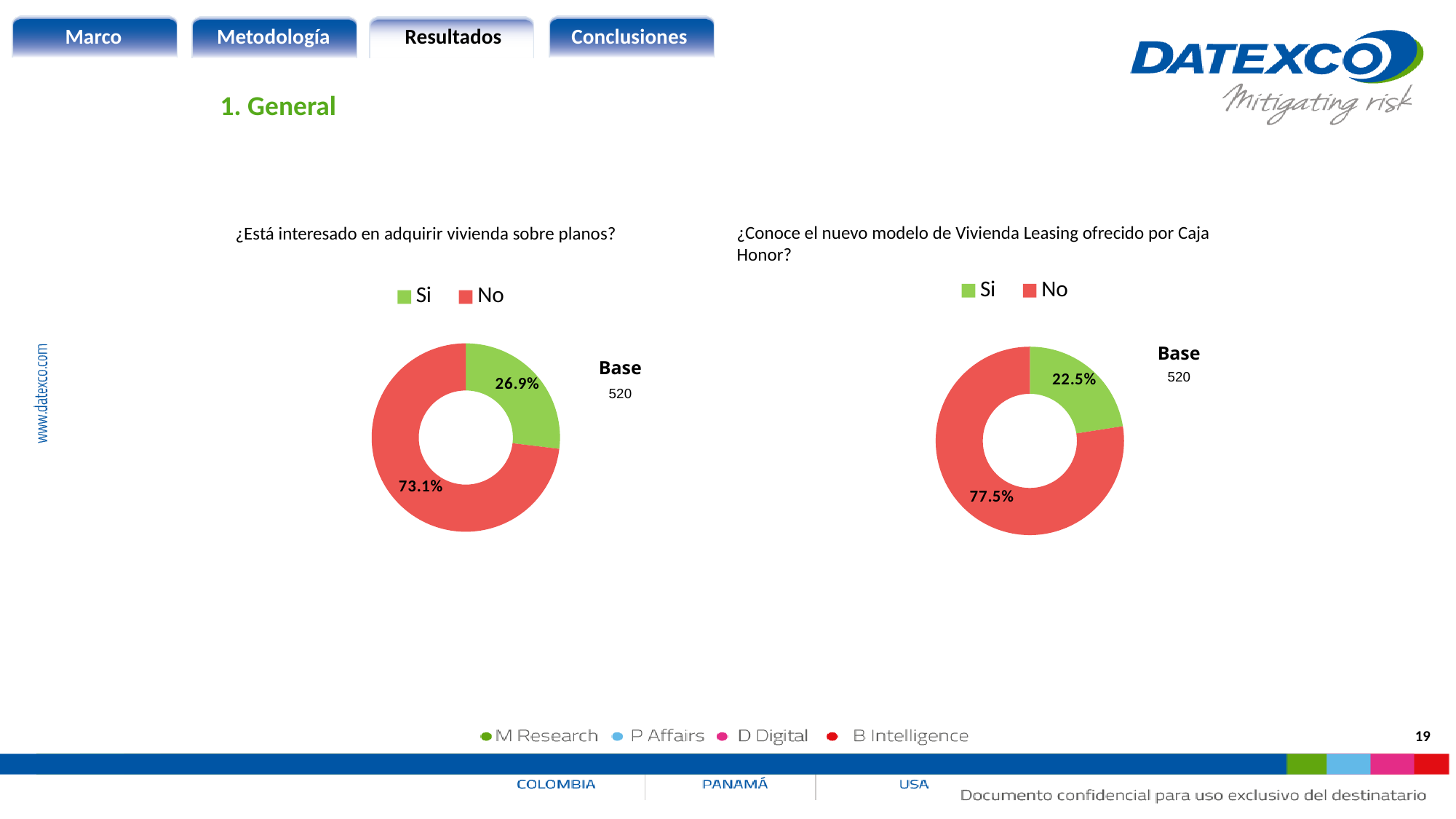
In the right chart, what is the difference between the No and Si percentages? 55.0% In the right chart (¿Conoce el nuevo modelo de Vivienda Leasing ofrecido por Caja Honor?), what percentage answered No? 77.5% What type of chart is used on the left of the slide? Doughnut (pie) chart In the left chart (¿Está interesado en adquirir vivienda sobre planos?), what percentage answered Si? 26.9% What is the Base shown next to the left chart? 520 In the left chart (¿Está interesado en adquirir vivienda sobre planos?), what percentage answered No? 73.1% In the left chart, which response has the largest share? No In the right chart (¿Conoce el nuevo modelo de Vivienda Leasing ofrecido por Caja Honor?), what percentage answered Si? 22.5% Which chart has the larger Si share, the left chart or the right chart? The left chart In the left chart, what is the difference between the No and Si percentages? 46.2% How many categories does the legend of the right chart list? 2 In the right chart, which response has the smallest share? Si